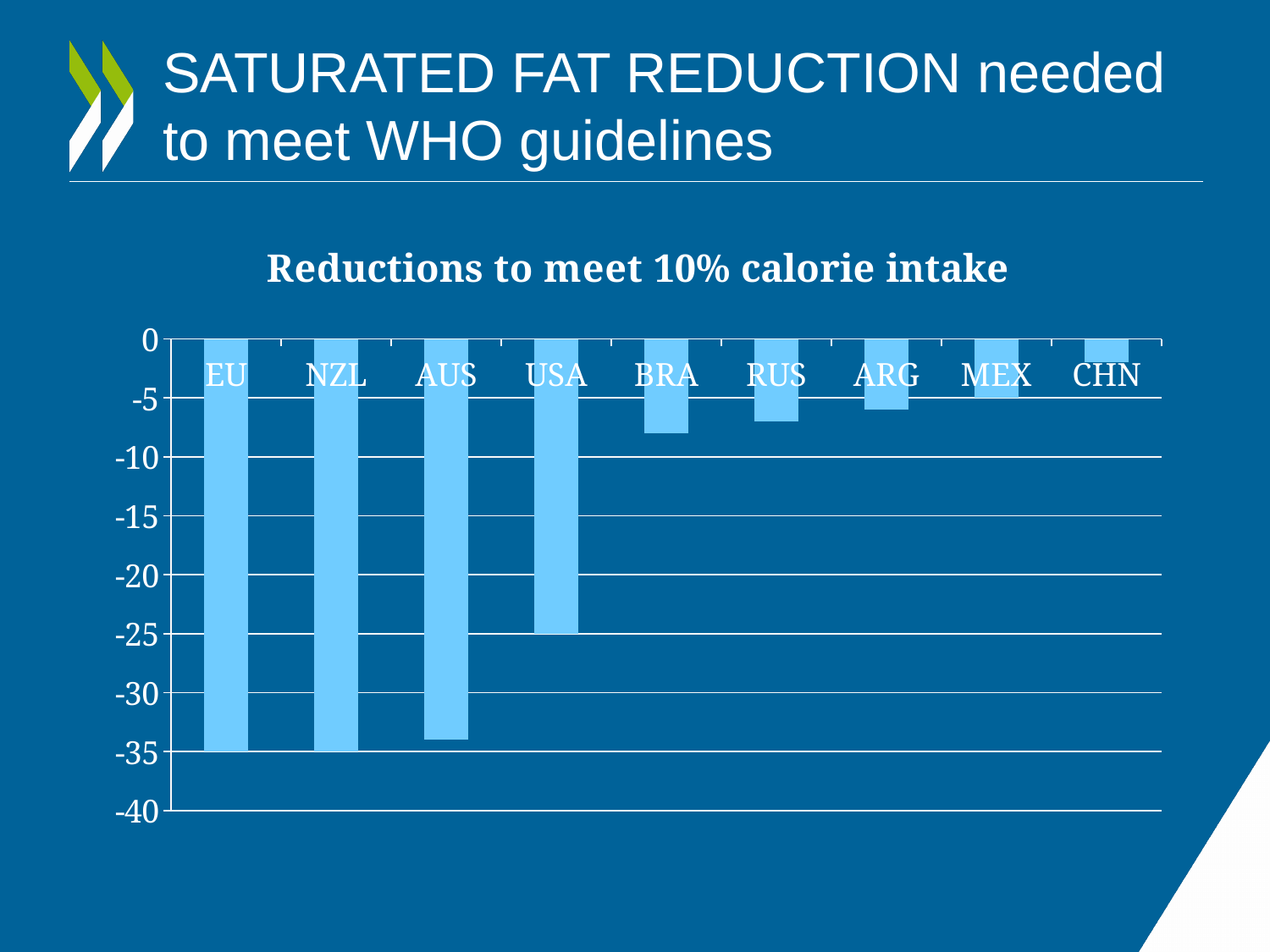
Is the value for USA greater or less than -20? less Is the value for CHN greater or less than -5? greater What is the title of the chart? Reductions to meet 10% calorie intake Which has the larger (less negative) value, USA or BRA? BRA Is the value for BRA greater or less than -5? less How many countries or regions are shown on the x axis of the chart? 9 Which category has the smallest reduction (the bar closest to zero)? CHN What kind of chart is shown on the slide? bar chart Do the values generally rise or fall moving from left to right along the x axis? rise What value does the USA bar reach on the y axis? -25